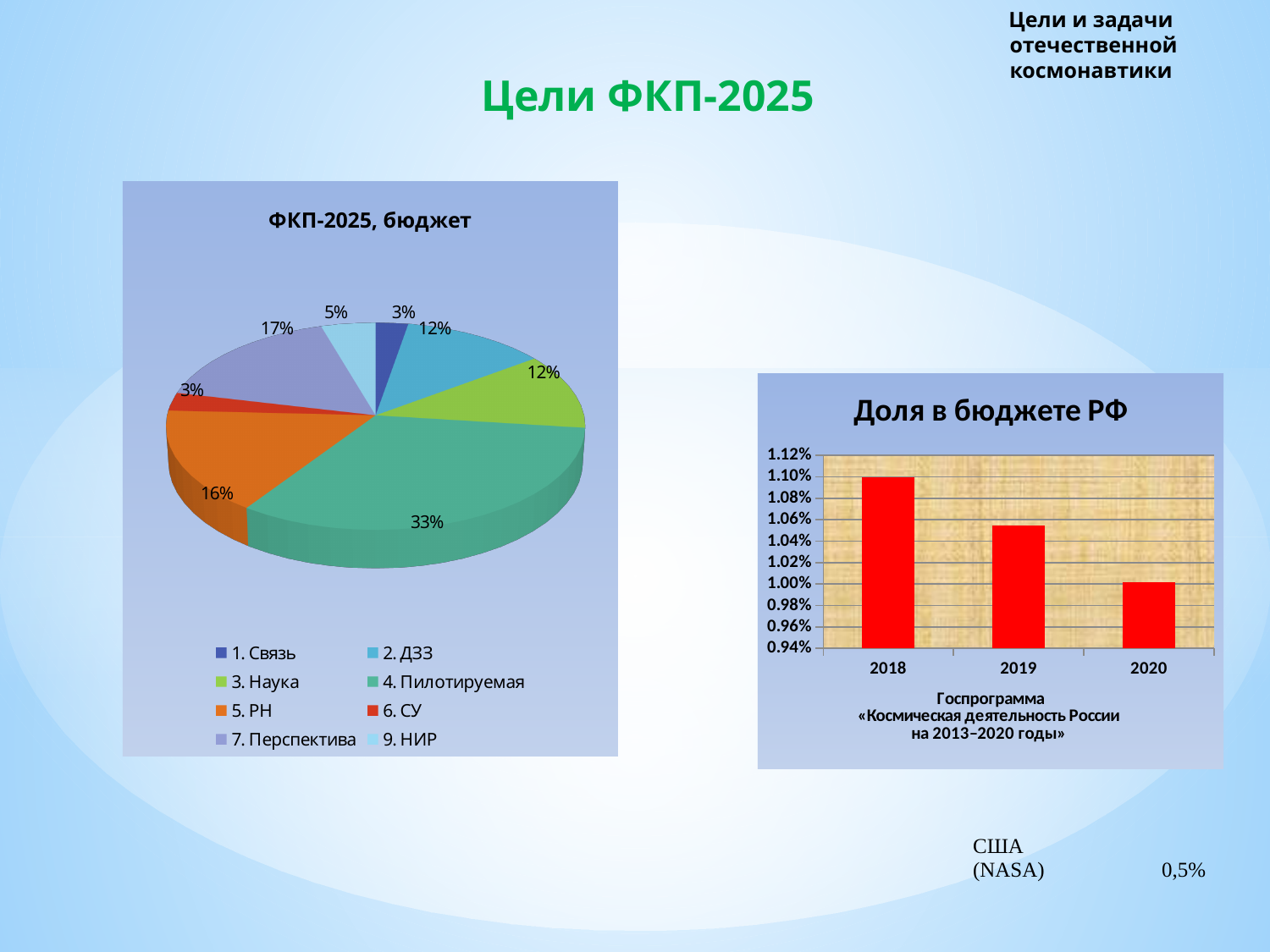
In the pie chart "ФКП-2025, бюджет", what share does "7. Перспектива" have? 17% What kind of chart is "Доля в бюджете РФ"? bar chart In the chart "Доля в бюджете РФ", is the value for 2019 greater or less than 1.04%? greater In the pie chart "ФКП-2025, бюджет", which is larger: the share of "7. Перспектива" or the share of "2. ДЗЗ"? 7. Перспектива In the chart "Доля в бюджете РФ", do the values rise or fall from 2018 to 2020? fall In the pie chart "ФКП-2025, бюджет", what share does "4. Пилотируемая" have? 33% In the pie chart "ФКП-2025, бюджет", which category has the largest share? 4. Пилотируемая In the chart "Доля в бюджете РФ", which year has the lowest value? 2020 In the pie chart "ФКП-2025, бюджет", what share does "9. НИР" have? 5% In the pie chart "ФКП-2025, бюджет", what is the difference between the shares of "4. Пилотируемая" and "5. РН"? 17% How many entries does the legend of the pie chart "ФКП-2025, бюджет" list? 8 In the pie chart "ФКП-2025, бюджет", what share does "5. РН" have? 16%